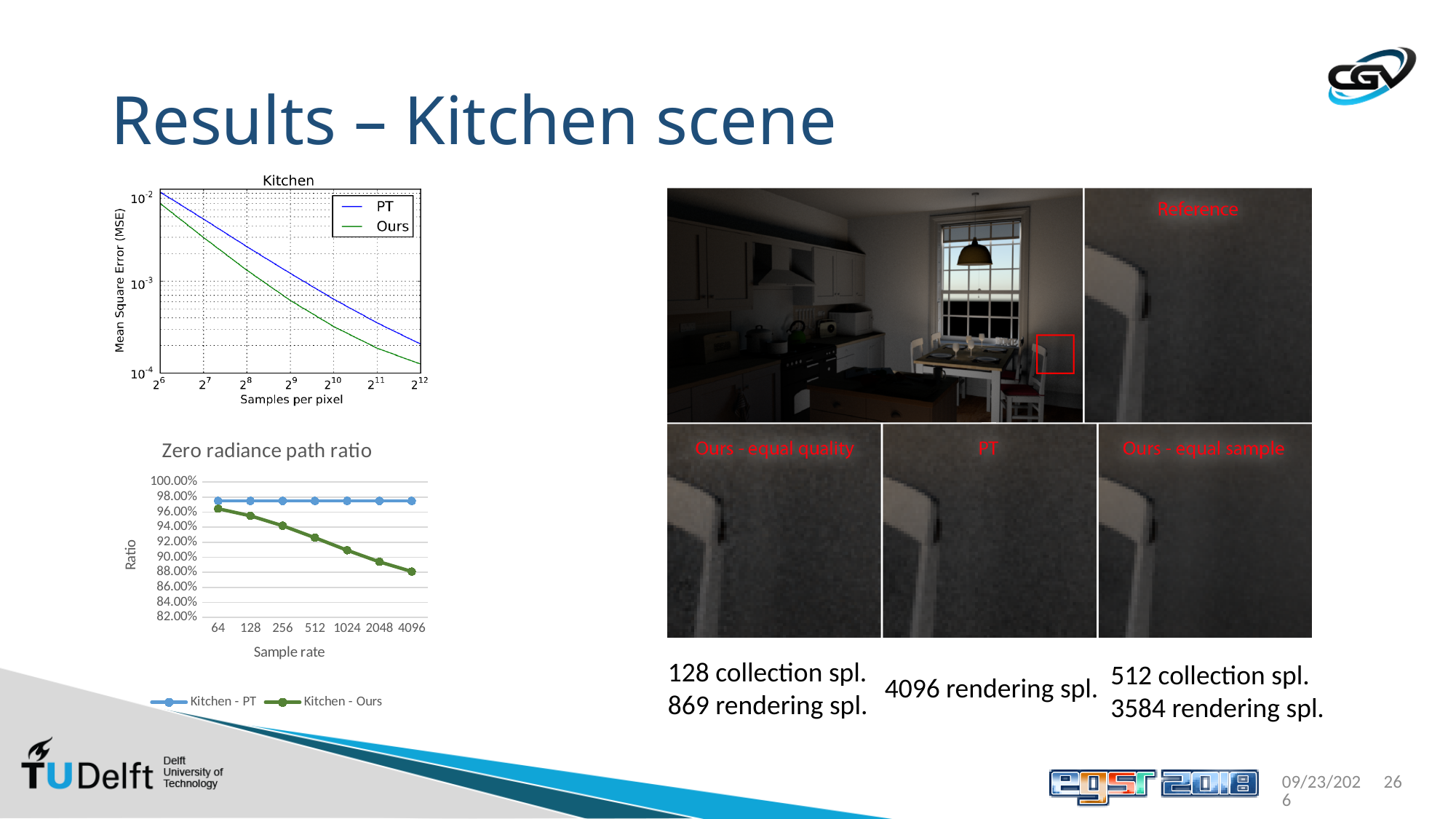
In the 'Kitchen' chart, how many series does the legend list? 2 What kind of chart is the 'Kitchen' chart at the top left? line chart In the 'Zero radiance path ratio' chart, does the ratio for Kitchen - Ours rise or fall as the sample rate increases? fall In the 'Kitchen' chart, does the Mean Square Error for PT rise or fall as samples per pixel increase? fall In the 'Zero radiance path ratio' chart, how many sample rate points are plotted on the x axis? 7 In the 'Zero radiance path ratio' chart, at which sample rate is the Kitchen - Ours ratio lowest? 4096 In the 'Kitchen' chart, what is the label of the x axis? Samples per pixel In the 'Zero radiance path ratio' chart, is the value for Kitchen - Ours at sample rate 4096 greater or less than 90.00%? less In the 'Zero radiance path ratio' chart, is the value for Kitchen - PT at sample rate 4096 greater or less than 96.00%? greater In the 'Zero radiance path ratio' chart, which series has the larger ratio at sample rate 2048, Kitchen - PT or Kitchen - Ours? Kitchen - PT In the 'Kitchen' chart, which series has the higher Mean Square Error at 2^9 samples per pixel, PT or Ours? PT In the 'Zero radiance path ratio' chart, how many series does the legend list? 2